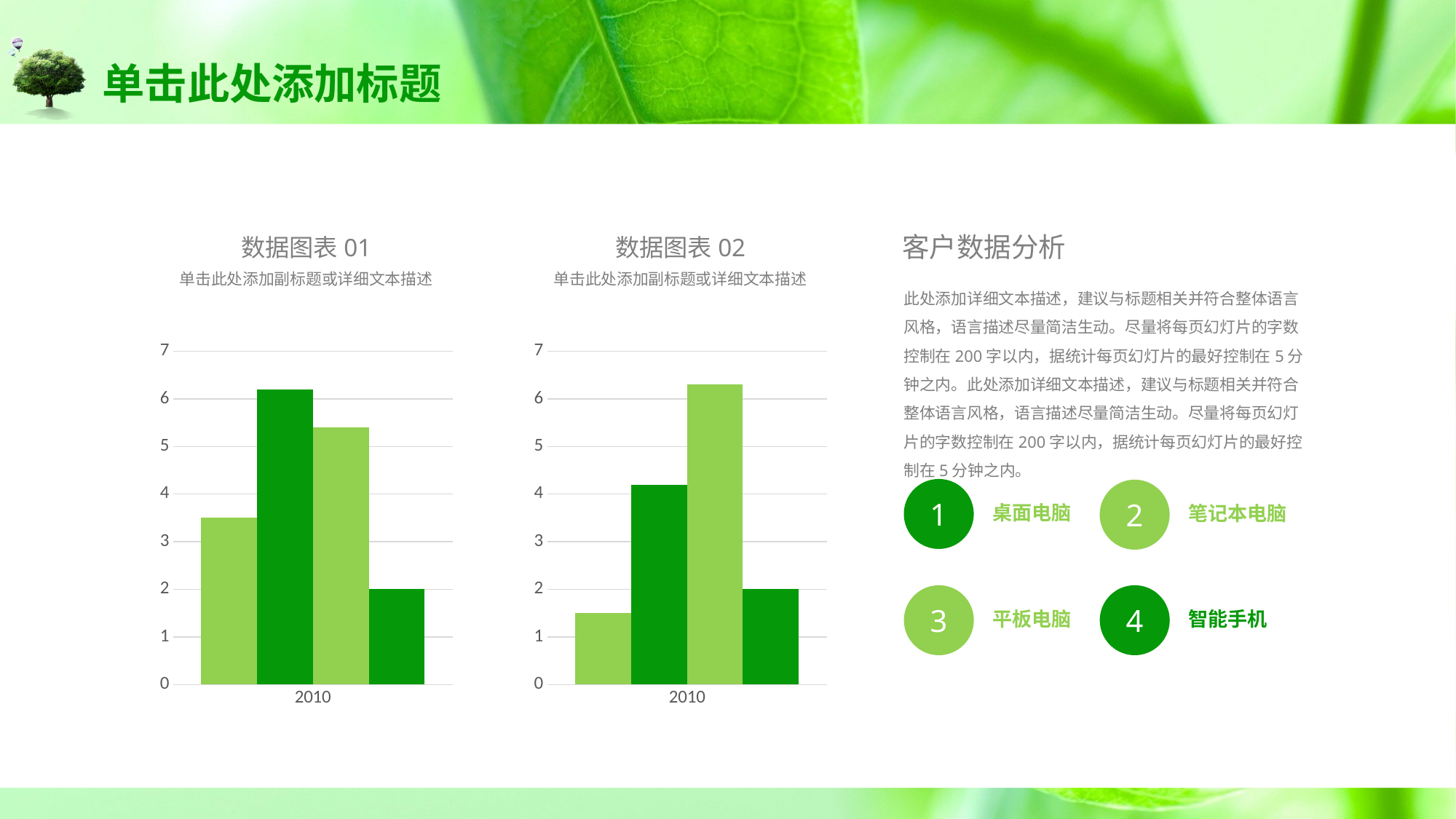
In 数据图表 02, is the value of the second bar greater or less than 5? less What kind of chart is 数据图表 01? bar chart In 数据图表 01, which bar is the shortest? the fourth bar In 数据图表 01, which bar is the tallest? the second bar In 数据图表 01, is the value of the first bar greater or less than 3? greater In 数据图表 02, which bar is the tallest? the third bar In 数据图表 01, how many bars are plotted? 4 In 数据图表 02, which bar is the shortest? the first bar In 数据图表 02, is the value of the third bar greater or less than 6? greater In 数据图表 01, which is larger, the second bar or the third bar? the second bar What is the category label on the x axis of 数据图表 02? 2010 In 数据图表 02, how many bars are plotted? 4